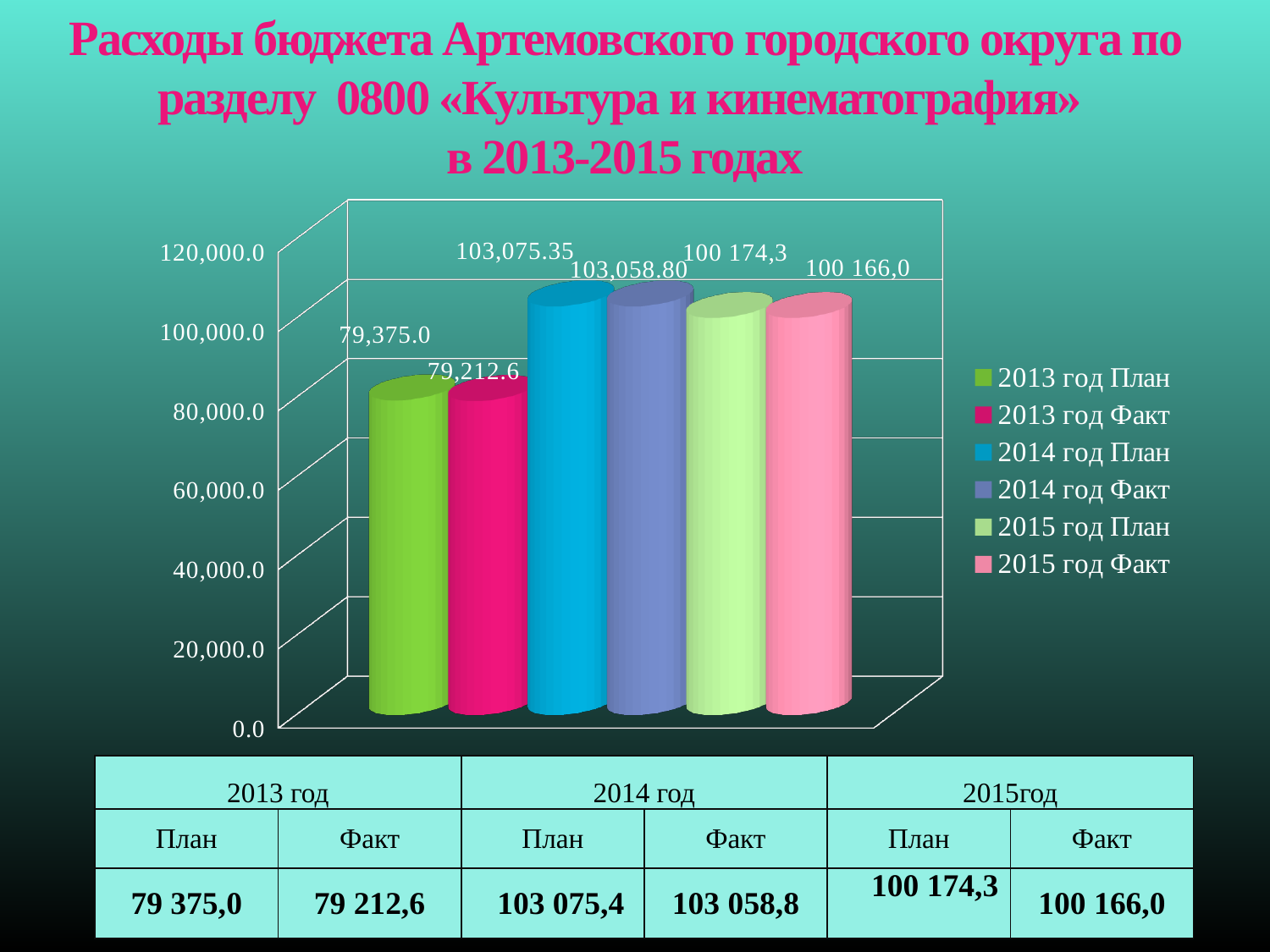
What is the value for 2015 год Факт? 100 166,0 What is the difference between 2014 год План and 2014 год Факт? 16.55 How many series does the legend list? 6 What is the value for 2014 год Факт? 103,058.80 How many bars are plotted on the chart? 6 What is the difference between 2013 год План and 2013 год Факт? 162.4 Is the value for 2015 год Факт greater or less than 100,000.0? greater What is the value for 2013 год План? 79,375.0 Which is larger, the value for 2014 год План or the value for 2015 год План? 2014 год План Which series has the lowest value? 2013 год Факт Which series has the highest value? 2014 год План What kind of chart is shown on the slide? bar chart